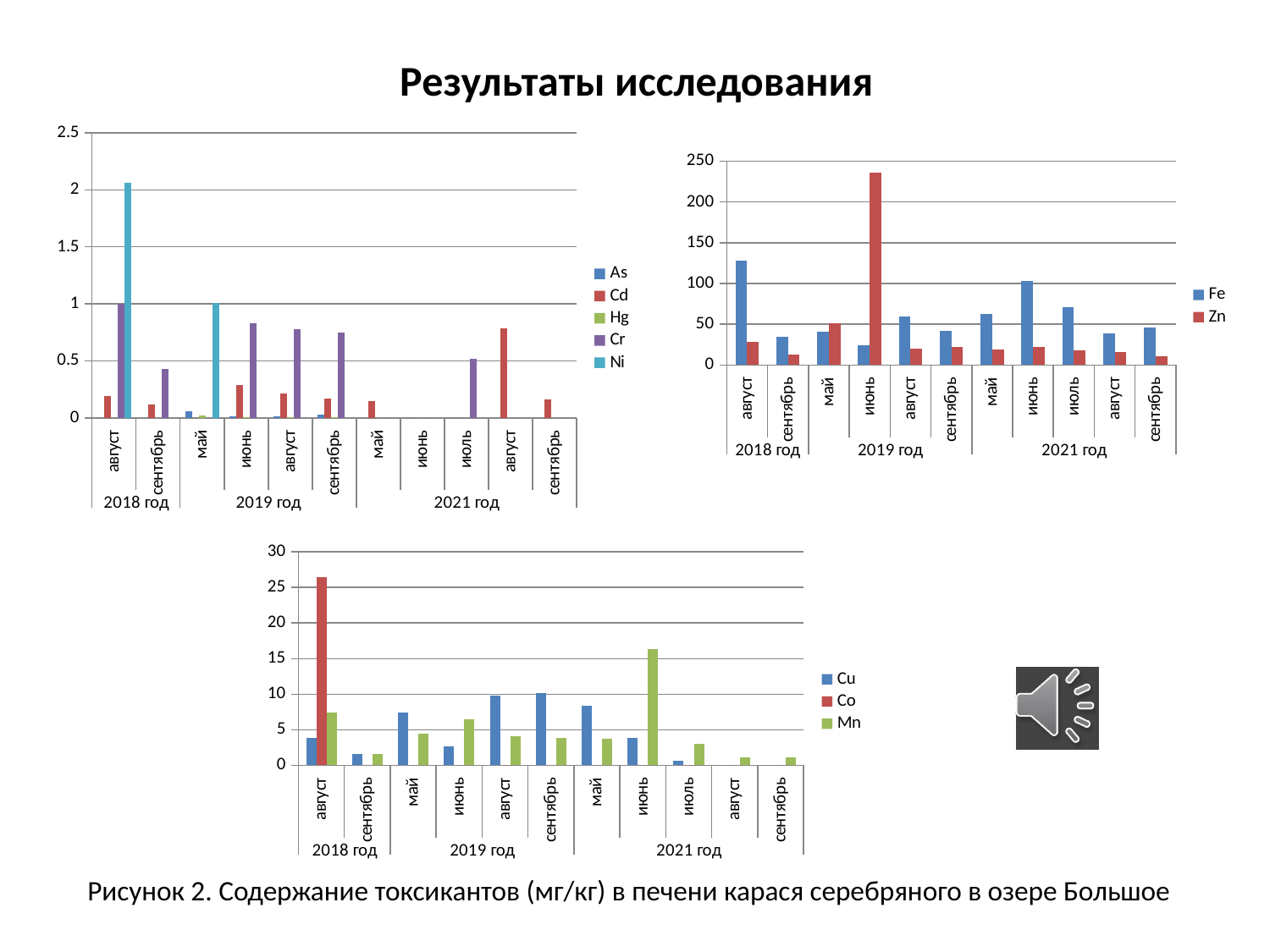
In the top-right chart, is the value of Fe for август 2018 greater or less than 100? greater In the bottom chart, in which month and year is the Mn value highest? июнь 2021 год In the top-right chart, how many series does the legend list? 2 In the bottom chart, how many series does the legend list? 3 In the top-right chart, in which month and year is the Zn value highest? июнь 2019 год In the top-left chart, is the value of Ni for август 2018 greater or less than 2? greater What kind of chart is the bottom chart? bar chart In the top-right chart, is the value of Zn for июнь 2019 greater or less than 200? greater In the top-left chart, how many series does the legend list? 5 In the bottom chart, which is larger for август 2018: Cu or Co? Co In the top-right chart, how many month categories are shown along the x axis? 11